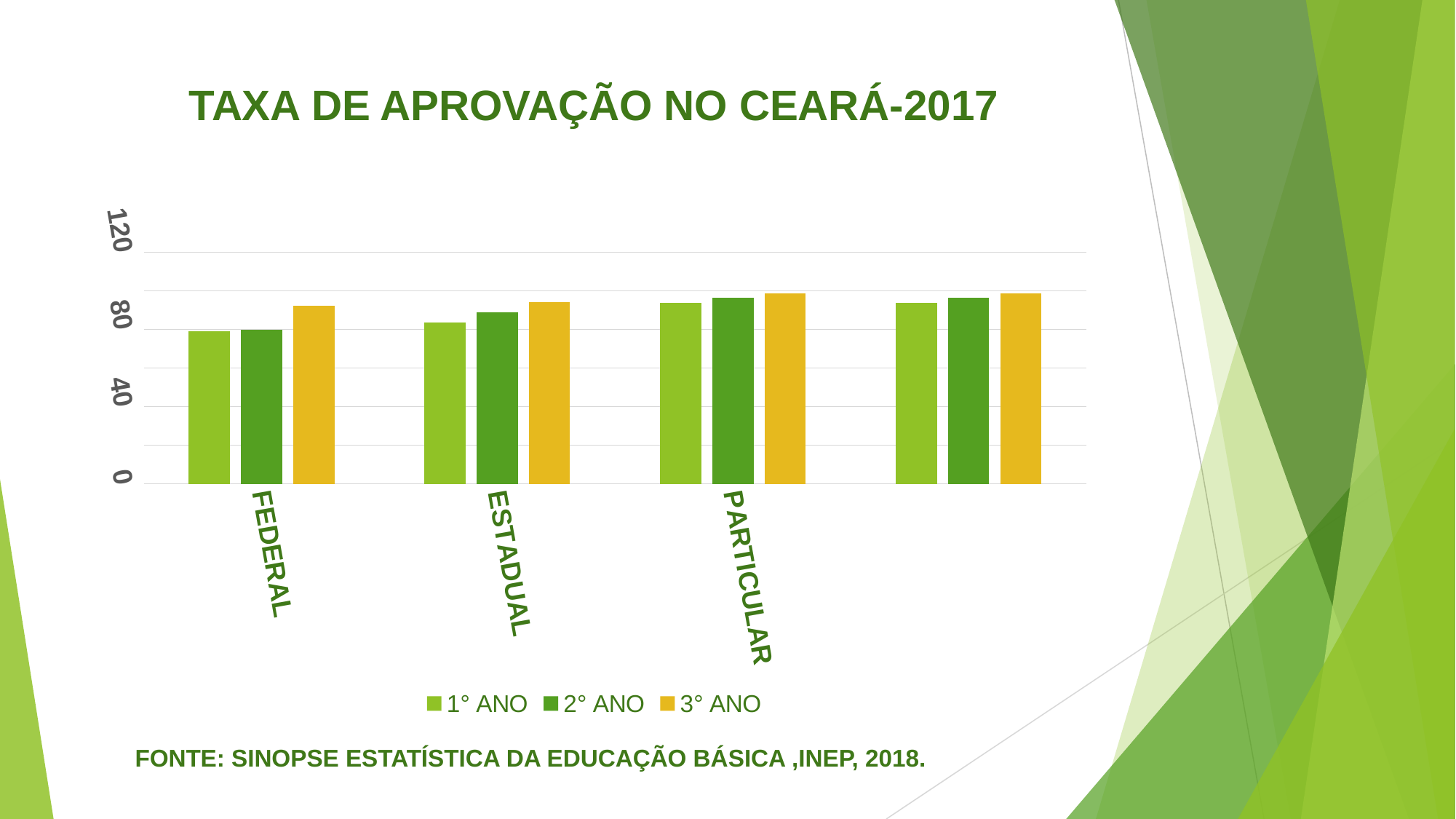
In the FEDERAL group, which series has the highest value? 3° ANO Is the value for 3° ANO in PARTICULAR greater or less than 120? less Within the FEDERAL group, do the values rise or fall from 1° ANO to 3° ANO? rise Is the value for 1° ANO in FEDERAL greater or less than 40? greater How many series does the legend list? 3 What is the title of the chart? TAXA DE APROVAÇÃO NO CEARÁ-2017 Which is larger: the 1° ANO value for FEDERAL or the 1° ANO value for PARTICULAR? PARTICULAR Which series does the yellow bar represent? 3° ANO What kind of chart is shown on the slide? bar chart Is the value for 1° ANO in ESTADUAL greater or less than 80? greater In the ESTADUAL group, which series has the lowest value? 1° ANO